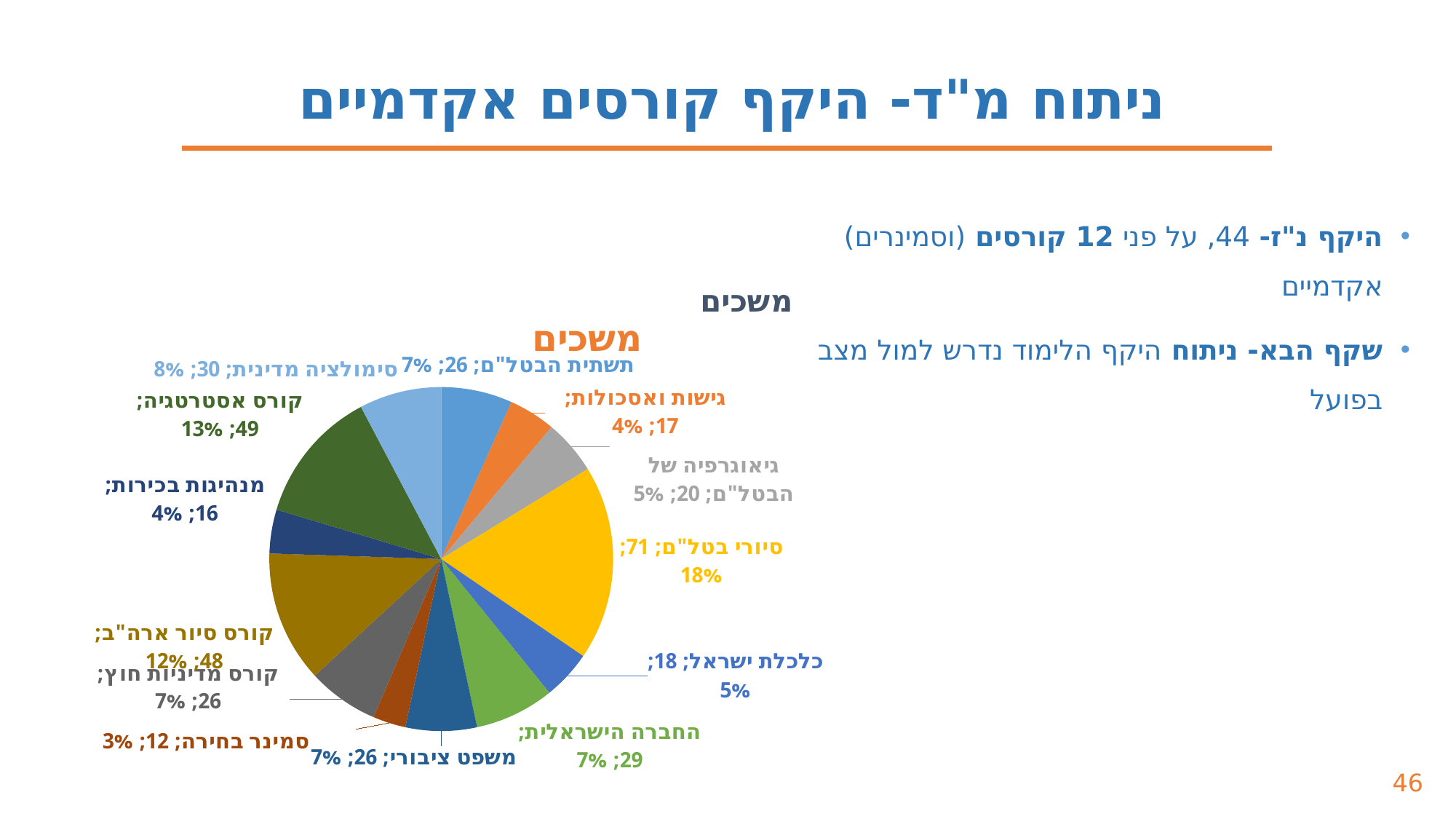
What share of the pie does סימולציה מדינית represent? 8% Which category has the largest slice in the pie chart? סיורי בטל"ם Which category has the smallest slice in the pie chart? סמינר בחירה What is the difference between the values for סיורי בטל"ם and קורס סיור ארה"ב? 23 What is the value for סיורי בטל"ם in the pie chart? 71 What is the value for קורס אסטרטגיה in the pie chart? 49 What is the title of the pie chart? משכים What share of the pie does סיורי בטל"ם represent? 18% What is the value for גיאוגרפיה של הבטל"ם in the pie chart? 20 What kind of chart is shown on the slide? pie chart What is the value for סמינר בחירה in the pie chart? 12 How many slices does the pie chart have? 13